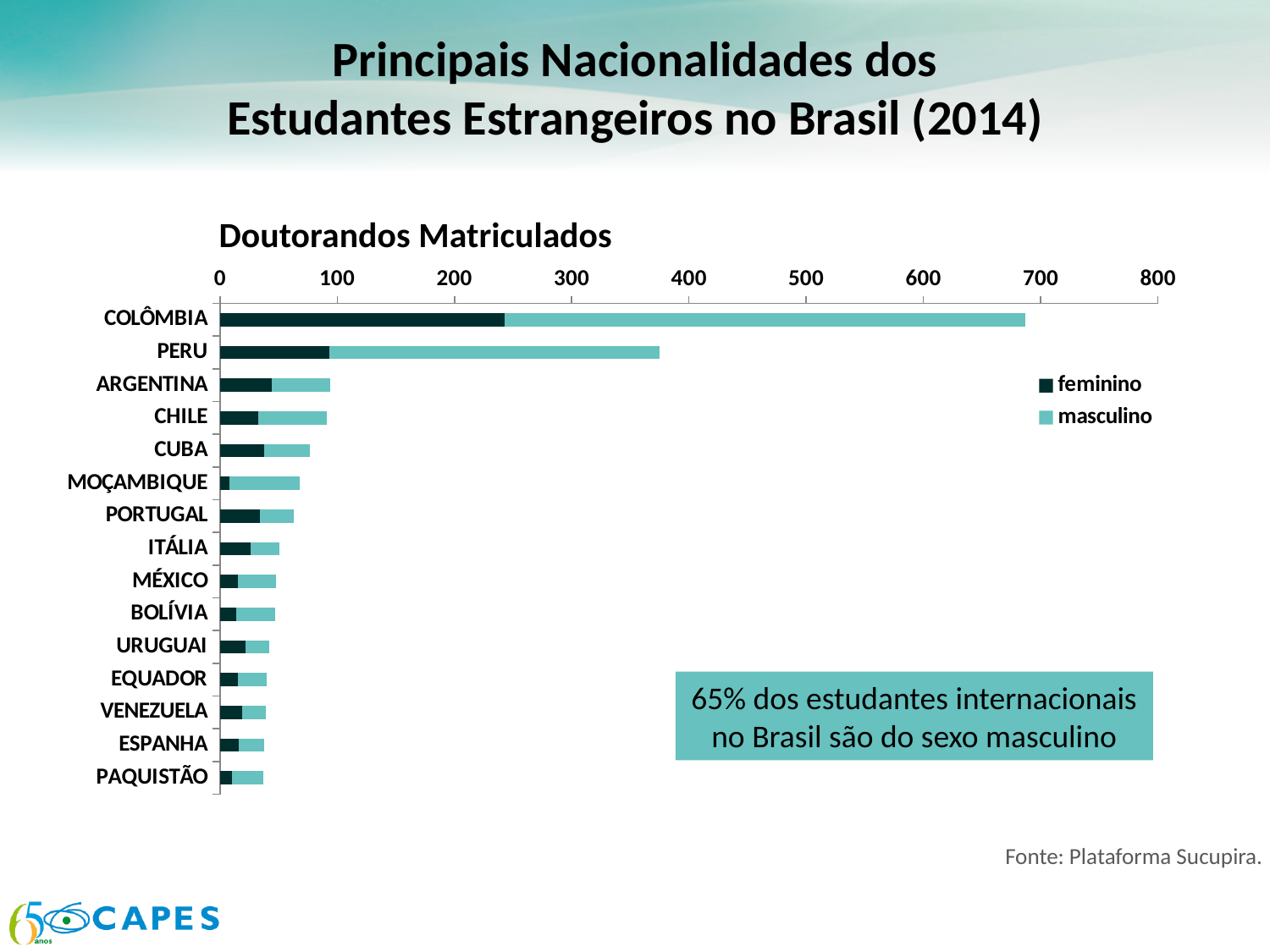
What is the title of the chart? Doutorandos Matriculados Which has a larger total bar, COLÔMBIA or PERU? COLÔMBIA How many nationalities (categories) are plotted in the chart? 15 Do the total bar lengths increase or decrease going from the top category to the bottom category? decrease Which nationality has the highest total number of enrolled doctoral students? COLÔMBIA How many series does the legend list? 2 Which series is shown in the dark colour in the legend? feminino What kind of chart is shown on the slide? Stacked bar chart Is the total value for PERU greater or less than 400? less Is the total value for COLÔMBIA greater or less than 600? greater Is the total value for CUBA greater or less than 100? less